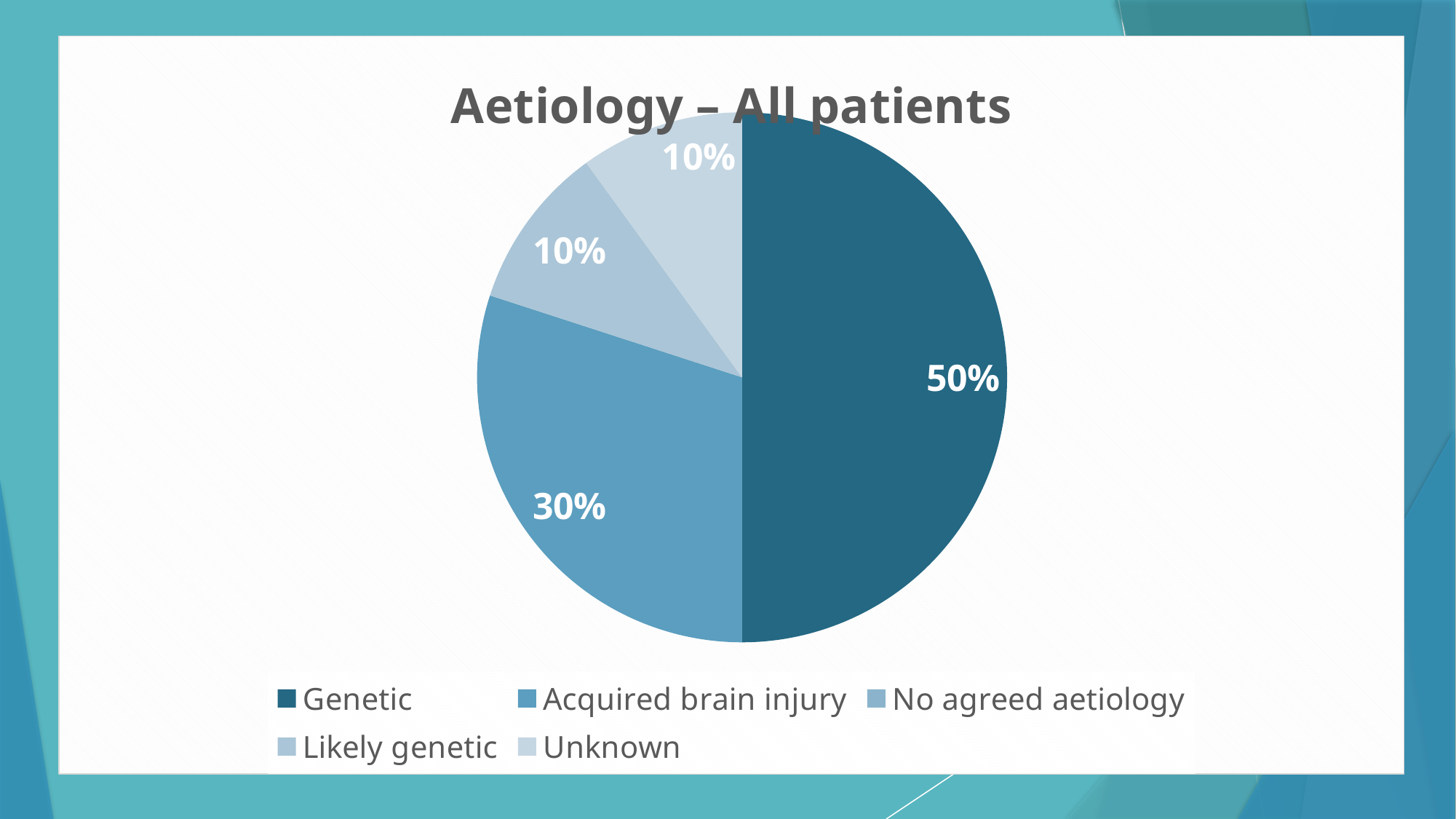
What percentage of patients have a Genetic aetiology? 50% Which is larger, the share for Genetic or the share for Acquired brain injury? Genetic What percentage of patients have an Acquired brain injury aetiology? 30% Which category has the largest share of the pie? Genetic How many percentage points larger is the Genetic share than the Acquired brain injury share? 20 percentage points What percentage of patients fall into the Likely genetic category? 10% How many categories does the legend list? 5 What is the title of the chart? Aetiology – All patients What kind of chart is shown on the slide? Pie chart What percentage of patients fall into the Unknown category? 10% Is the share for Acquired brain injury greater or less than 25%? greater What is the combined share of Genetic and Acquired brain injury? 80%